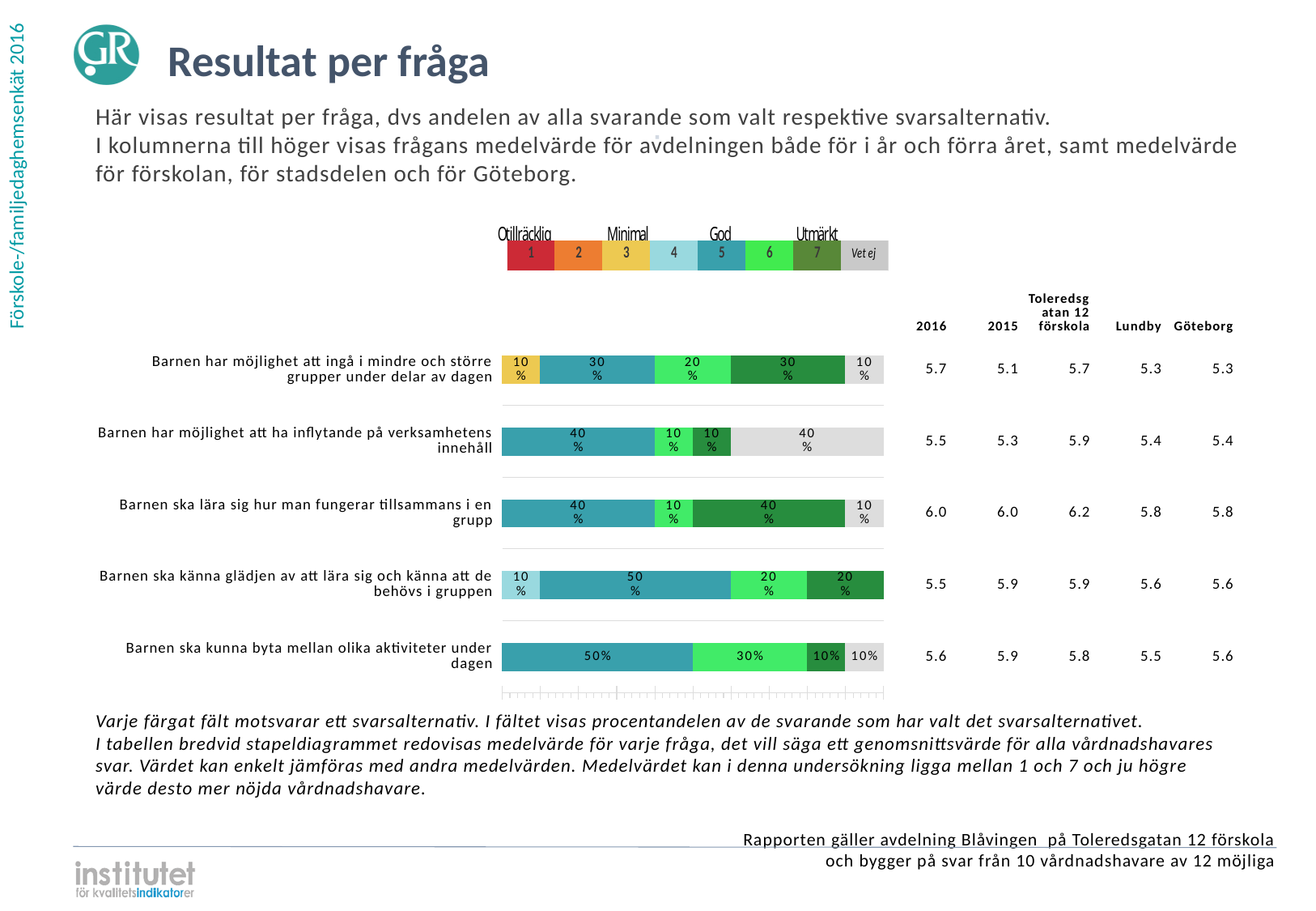
How many answer options does the colour legend above the chart list, including 'Vet ej'? 8 What is the difference between the option 5 share and the option 7 share for 'Barnen ska kunna byta mellan olika aktiviteter under dagen'? 40% For 'Barnen har möjlighet att ingå i mindre och större grupper under delar av dagen', which is larger: the share for option 5 or the share for option 6? Option 5 What is the 2016 mean value shown for 'Barnen ska lära sig hur man fungerar tillsammans i en grupp'? 6.0 What percentage of respondents chose 'Vet ej' for 'Barnen har möjlighet att ha inflytande på verksamhetens innehåll'? 40% What is the total of all segments in the bar for 'Barnen ska lära sig hur man fungerar tillsammans i en grupp'? 100% What label does the legend give to answer option 7? Utmärkt How many questions (categories) are shown as bars in the chart? 5 What kind of chart is used to show the results per question on this slide? Stacked bar chart What percentage of respondents chose option 7 (Utmärkt) for 'Barnen ska lära sig hur man fungerar tillsammans i en grupp'? 40% Which answer option has the largest share for 'Barnen ska känna glädjen av att lära sig och känna att de behövs i gruppen'? 5 What percentage of respondents chose option 5 for 'Barnen ska kunna byta mellan olika aktiviteter under dagen'? 50%